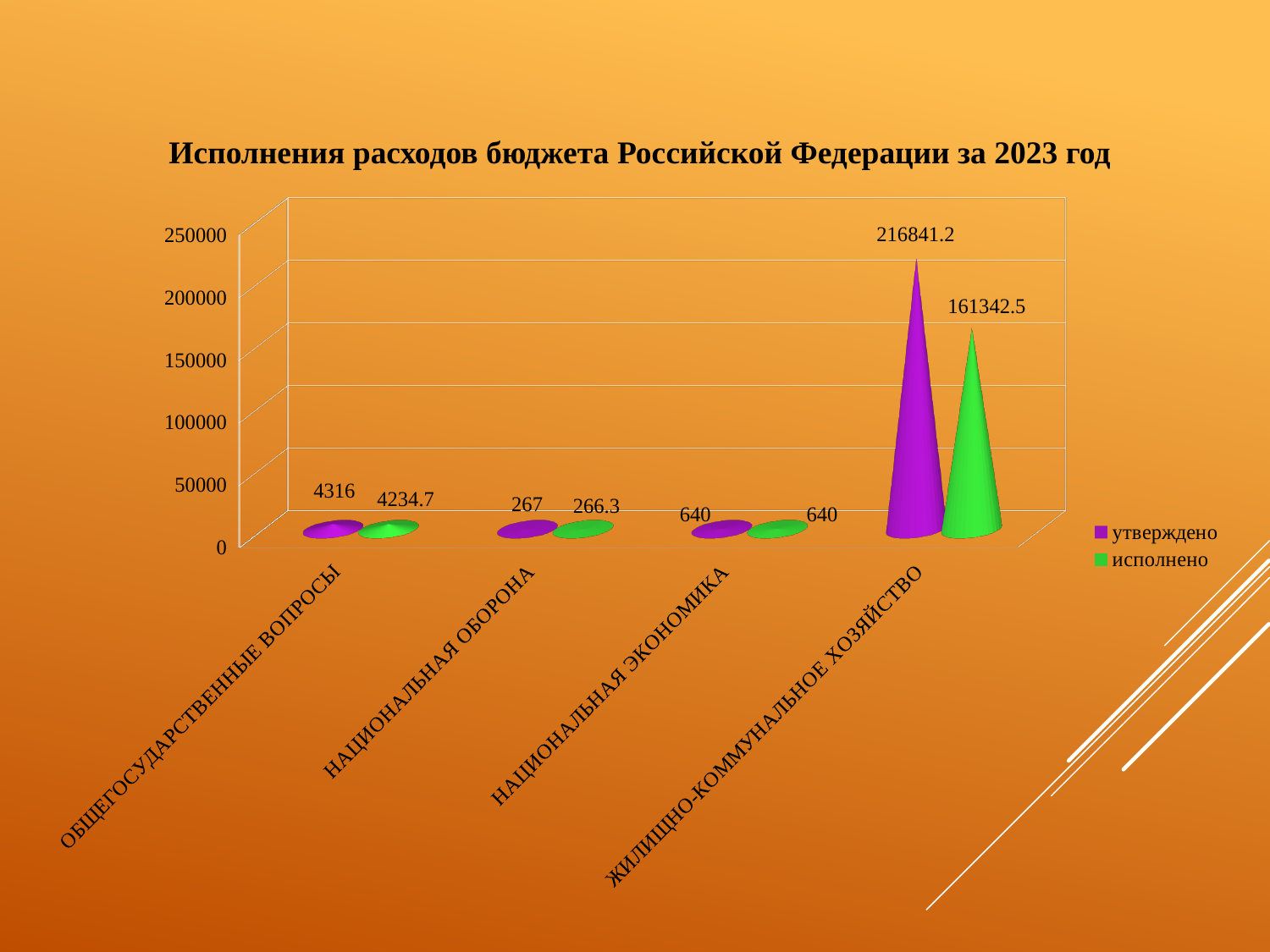
Which category has the highest утверждено value? ЖИЛИЩНО-КОММУНАЛЬНОЕ ХОЗЯЙСТВО What is the difference between the утверждено and исполнено values for ЖИЛИЩНО-КОММУНАЛЬНОЕ ХОЗЯЙСТВО? 55498.7 What is the утверждено value for ОБЩЕГОСУДАРСТВЕННЫЕ ВОПРОСЫ? 4316 What is the исполнено value for ЖИЛИЩНО-КОММУНАЛЬНОЕ ХОЗЯЙСТВО? 161342.5 What is the исполнено value for НАЦИОНАЛЬНАЯ ОБОРОНА? 266.3 What is the утверждено value for ЖИЛИЩНО-КОММУНАЛЬНОЕ ХОЗЯЙСТВО? 216841.2 Which category has the lowest исполнено value? НАЦИОНАЛЬНАЯ ОБОРОНА Which is larger for НАЦИОНАЛЬНАЯ ЭКОНОМИКА: the утверждено value or the исполнено value? They are equal (640) What is the title of the chart? Исполнения расходов бюджета Российской Федерации за 2023 год How many categories are shown on the x axis? 4 How many series does the legend list? 2 What is the difference between the утверждено and исполнено values for ОБЩЕГОСУДАРСТВЕННЫЕ ВОПРОСЫ? 81.3